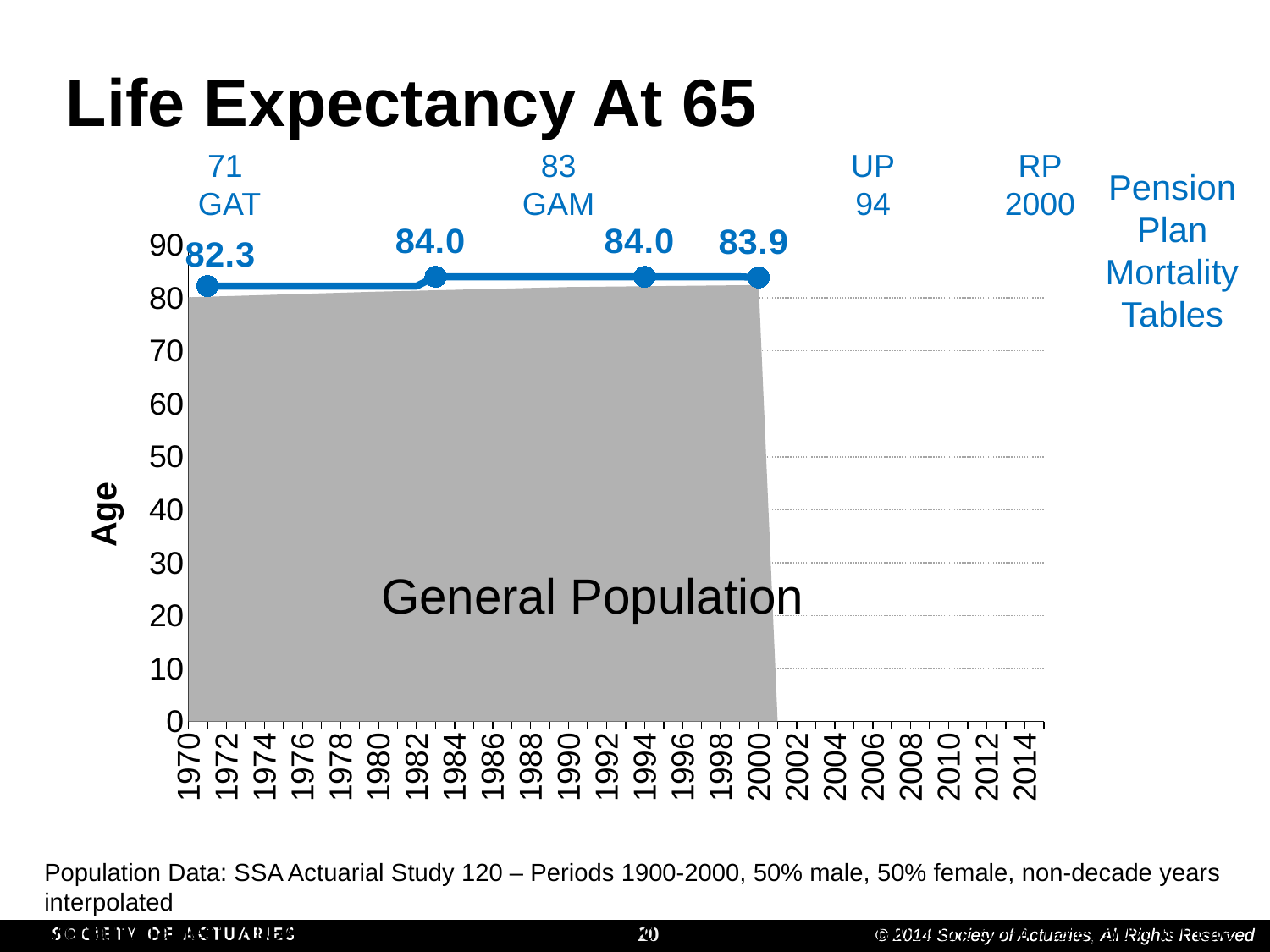
What is the title of the chart? Life Expectancy At 65 How many pension plan mortality table data points are labeled on the chart? 4 What is the label of the vertical axis of the chart? Age Which pension plan mortality table has the lowest life expectancy at 65 on the chart? 71 GAT What is the life expectancy at 65 shown for the 71 GAT pension plan mortality table? 82.3 Is the general population life expectancy at 65 in 2000 greater or less than 90? less What is the life expectancy at 65 shown for the 83 GAM pension plan mortality table? 84.0 What is the life expectancy at 65 shown for the UP 94 pension plan mortality table? 84.0 What is the difference between the life expectancy at 65 for UP 94 and for RP 2000? 0.1 What is the life expectancy at 65 shown for the RP 2000 pension plan mortality table? 83.9 Which has a higher life expectancy at 65, 71 GAT or RP 2000? RP 2000 What is the difference between the life expectancy at 65 for 83 GAM and for 71 GAT? 1.7